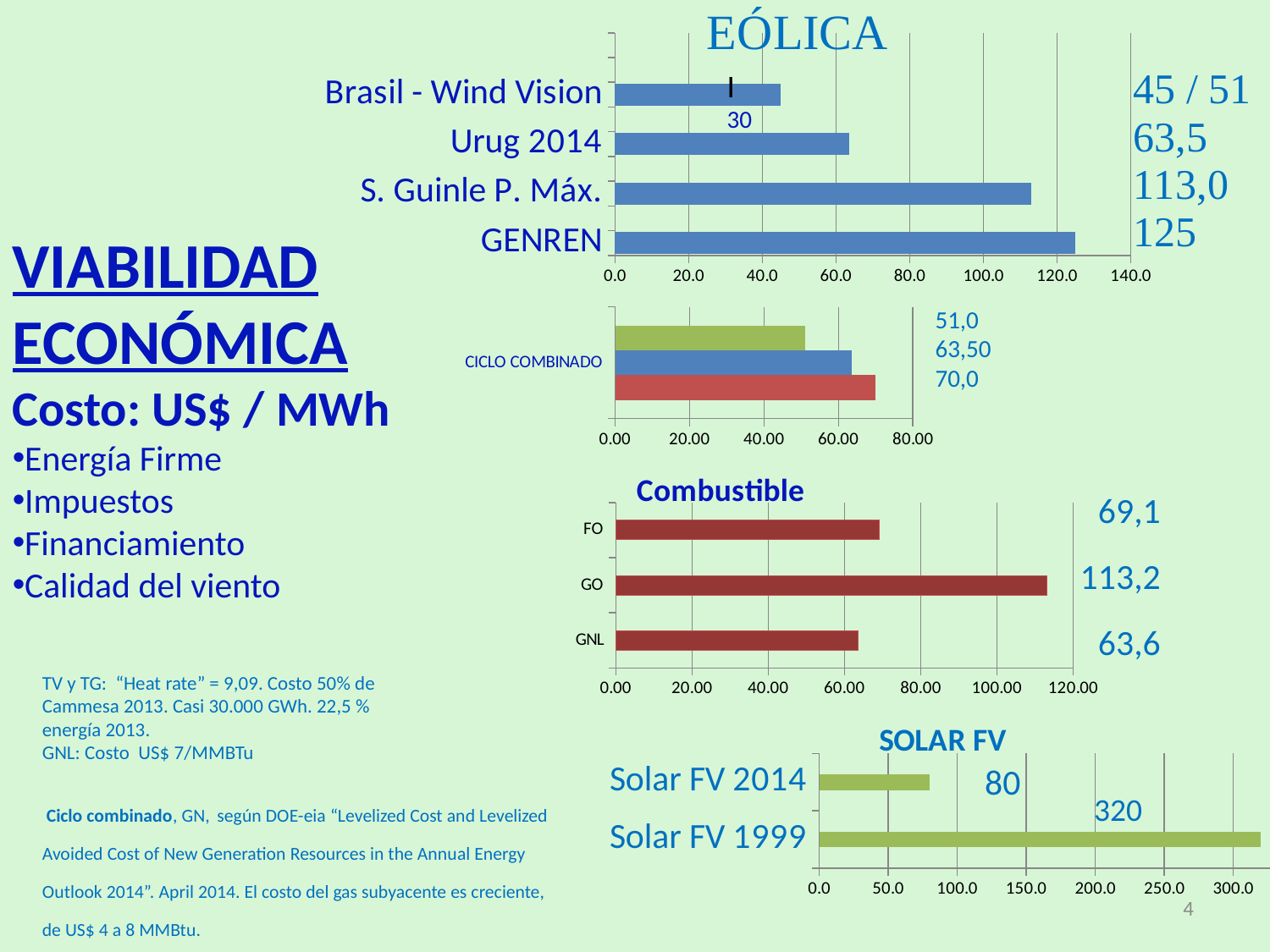
In the SOLAR FV chart, what is the value shown for Solar FV 1999? 320 What kind of chart is the SOLAR FV chart? bar chart In the EÓLICA chart, what is the value shown for Urug 2014? 63,5 In the Combustible chart, which is larger, FO or GNL? FO In the Combustible chart, what is the value shown for GO? 113,2 In the EÓLICA chart, what is the value shown for GENREN? 125 In the EÓLICA chart, how many categories are plotted? 4 In the CICLO COMBINADO chart, what is the highest value shown? 70,0 In the EÓLICA chart, is the bar for Brasil - Wind Vision greater or less than 60.0? less In the Combustible chart, which category has the lowest value? GNL In the EÓLICA chart, which category has the longest bar? GENREN In the CICLO COMBINADO chart, how many bars are plotted? 3